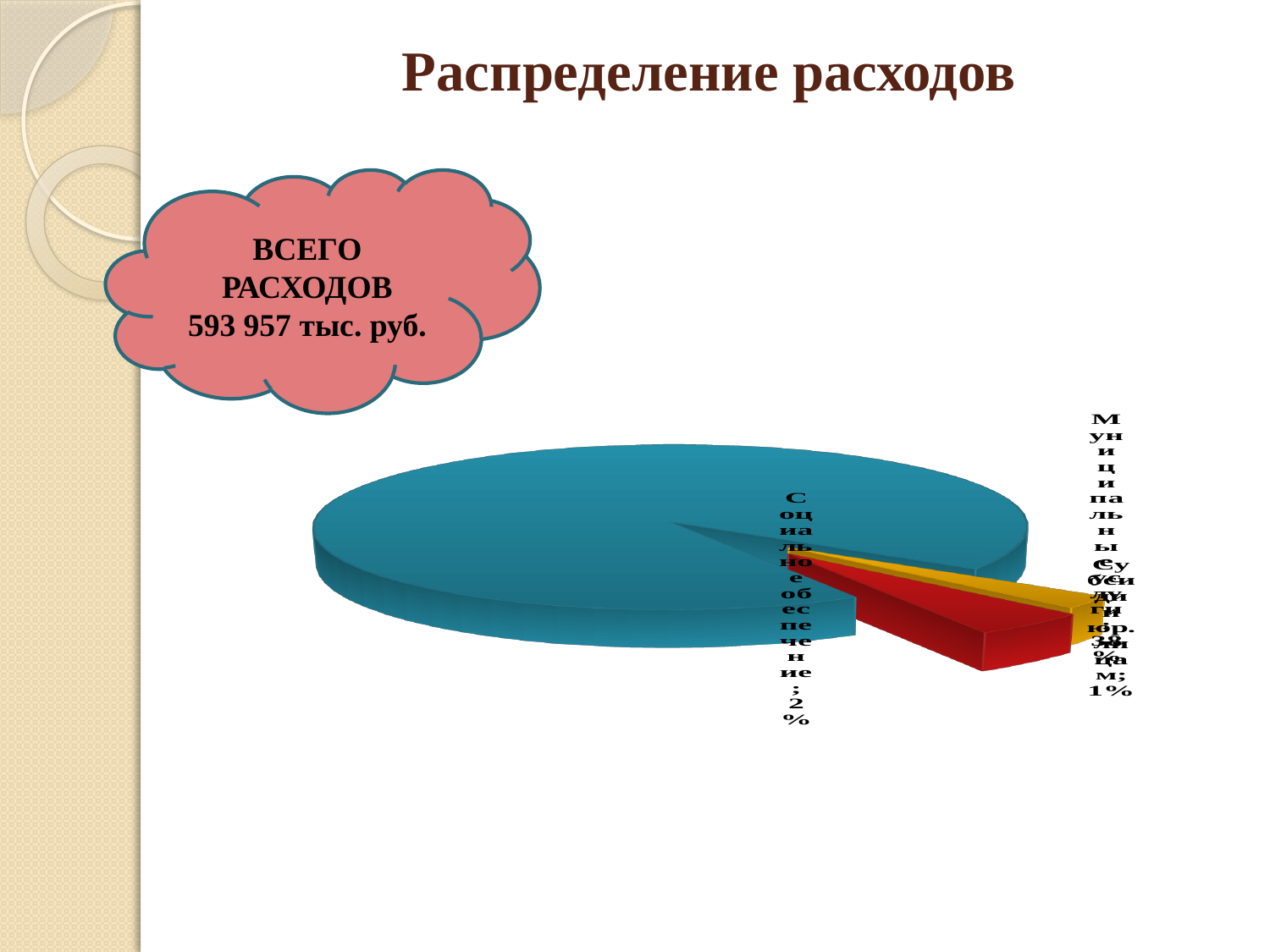
Which slice is larger, the red one or the yellow one? the red one Which colour slice is the largest in the pie chart? blue What kind of chart is shown on the slide? pie chart What share of the pie does Социальное обеспечение have? 2% Is the share for Социальное обеспечение greater or less than 10%? less What is the title of the chart on the slide? Распределение расходов How many slices are visible in the pie chart? 3 What total amount of expenses is stated in the cloud callout on the slide? 593 957 тыс. руб.